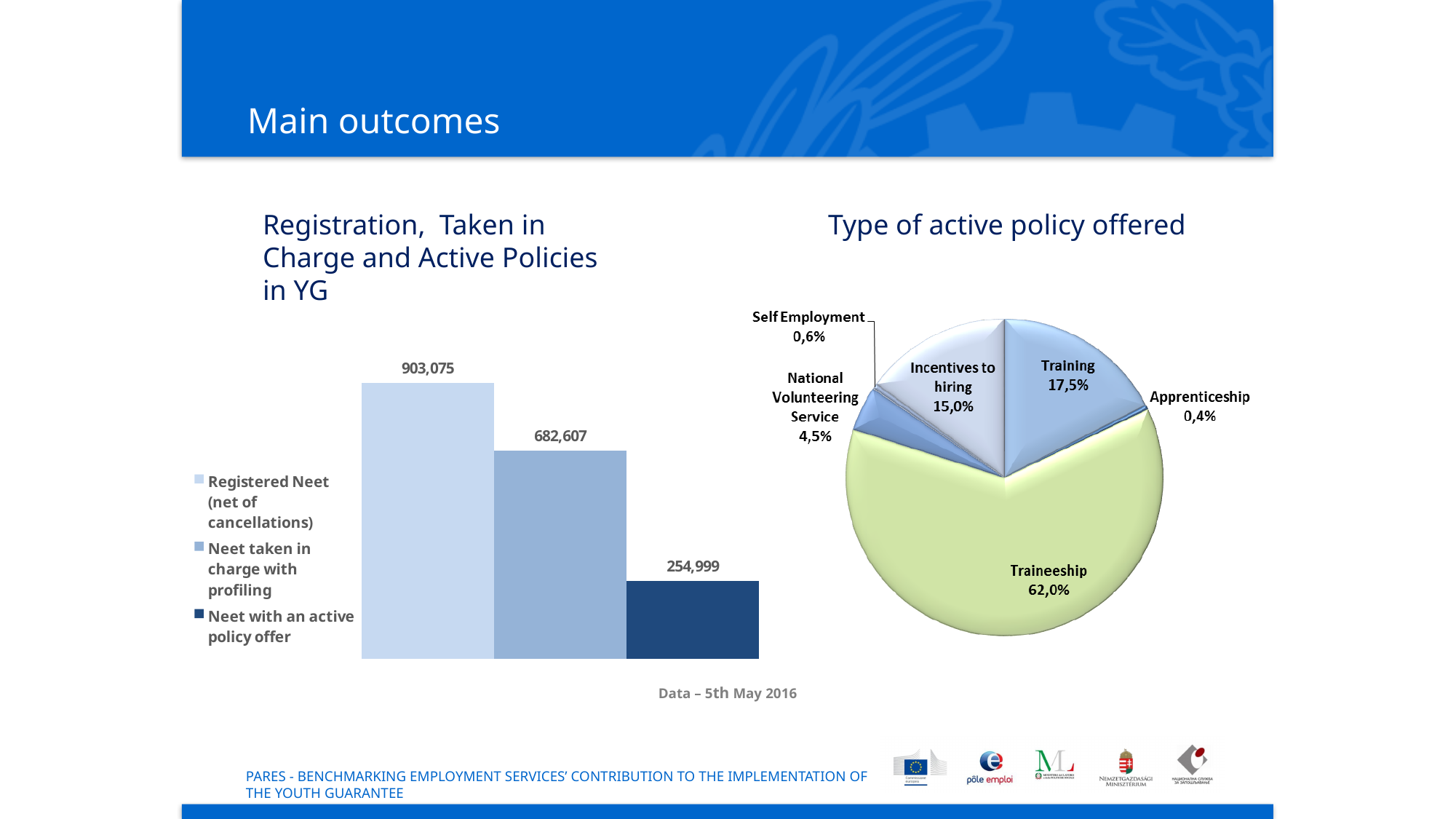
In the chart 'Registration, Taken in Charge and Active Policies in YG', what is the difference between Registered Neet (net of cancellations) and Neet taken in charge with profiling? 220,468 In the chart 'Type of active policy offered', which is larger: Incentives to hiring or National Volunteering Service? Incentives to hiring In the chart 'Type of active policy offered', how many slices does the pie have? 6 In the chart 'Registration, Taken in Charge and Active Policies in YG', what is the value for Neet taken in charge with profiling? 682,607 In the chart 'Registration, Taken in Charge and Active Policies in YG', how many series does the legend list? 3 In the chart 'Registration, Taken in Charge and Active Policies in YG', what is the value for Neet with an active policy offer? 254,999 In the chart 'Type of active policy offered', which policy type has the smallest share? Apprenticeship In the chart 'Type of active policy offered', what share does Traineeship have? 62,0% In the chart 'Registration, Taken in Charge and Active Policies in YG', which series has the lowest value? Neet with an active policy offer What kind of chart is 'Registration, Taken in Charge and Active Policies in YG'? Bar chart In the chart 'Registration, Taken in Charge and Active Policies in YG', what is the value for Registered Neet (net of cancellations)? 903,075 In the chart 'Type of active policy offered', what share does Training have? 17,5%